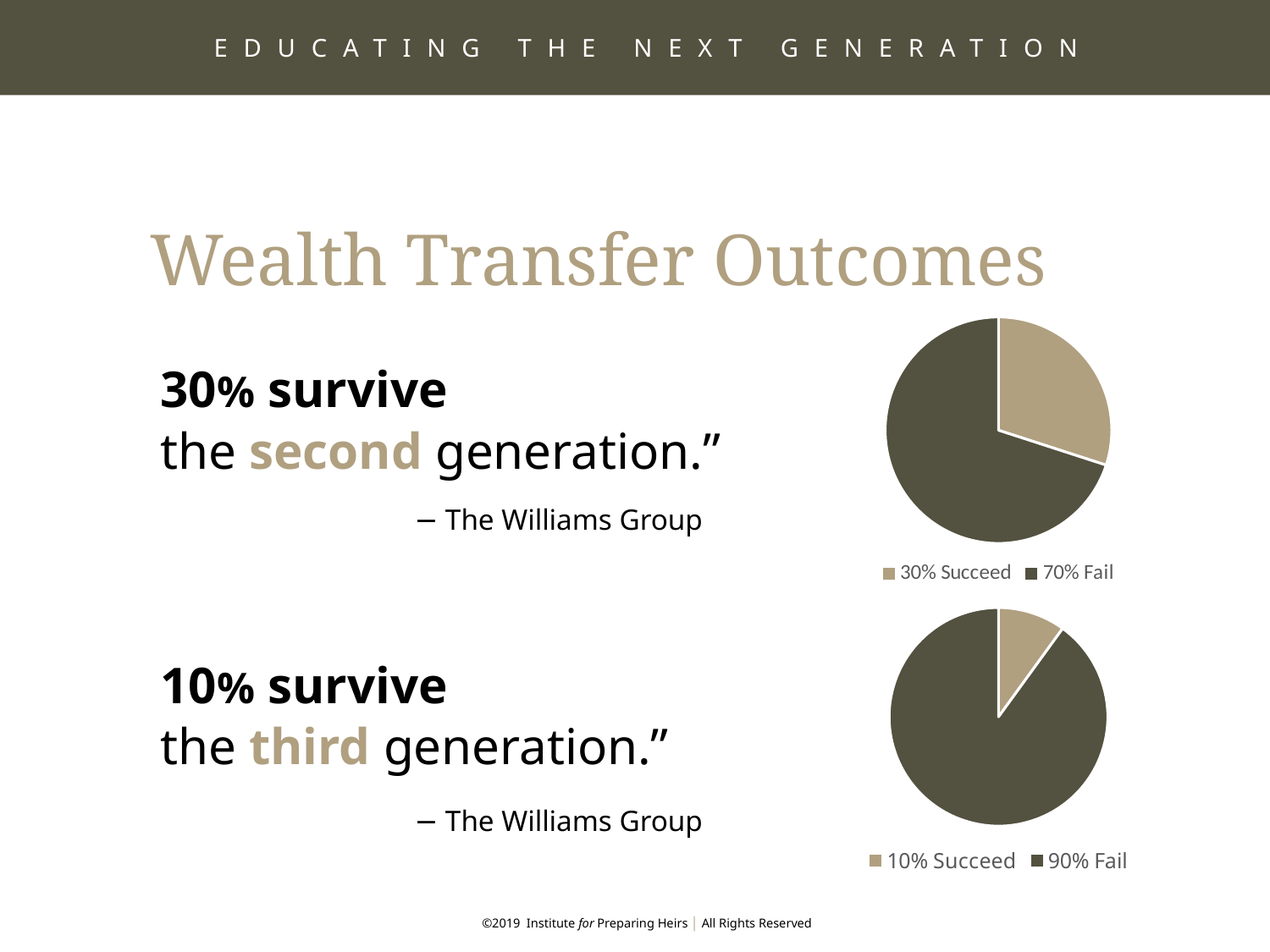
What kind of chart is the top chart on the right side of the slide? pie chart In the bottom pie chart, what share of the pie does the Fail slice represent? 90% In the top pie chart, which slice is larger, Succeed or Fail? Fail How many entries does the legend of the bottom pie chart list? 2 In the bottom pie chart, which slice is the smallest? 10% Succeed In the top pie chart, what share of the pie does the Succeed slice represent? 30% In the bottom pie chart, what is the difference between the Fail share and the Succeed share? 80% In the bottom pie chart, what colour is the Fail slice? dark olive green In the bottom pie chart, what share of the pie does the Succeed slice represent? 10% In the top pie chart, what is the difference between the Fail share and the Succeed share? 40% How many slices does the top pie chart have? 2